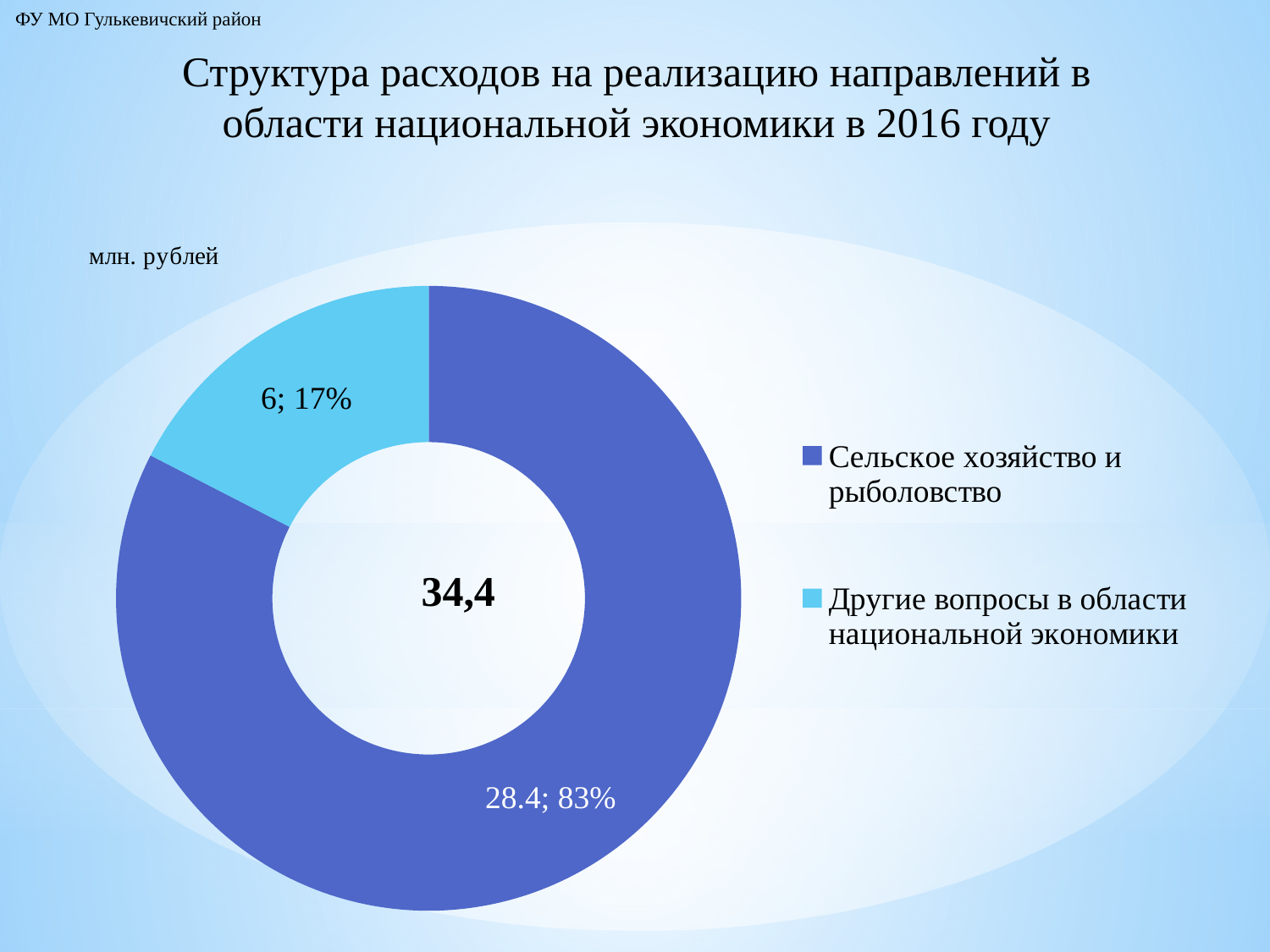
Which category has the smallest value? Другие вопросы в области национальной экономики What unit is indicated for the chart values? млн. рублей What is the value for Другие вопросы в области национальной экономики? 6 What kind of chart is shown on the slide? Doughnut (pie) chart What share of the chart does Сельское хозяйство и рыболовство take? 83% What is the difference between the values for Сельское хозяйство и рыболовство and Другие вопросы в области национальной экономики? 22.4 What total value is printed in the centre of the chart? 34,4 What share of the chart does Другие вопросы в области национальной экономики take? 17% How many categories does the chart show? 2 Which is larger: Сельское хозяйство и рыболовство or Другие вопросы в области национальной экономики? Сельское хозяйство и рыболовство Which category has the largest value? Сельское хозяйство и рыболовство What is the value for Сельское хозяйство и рыболовство? 28.4